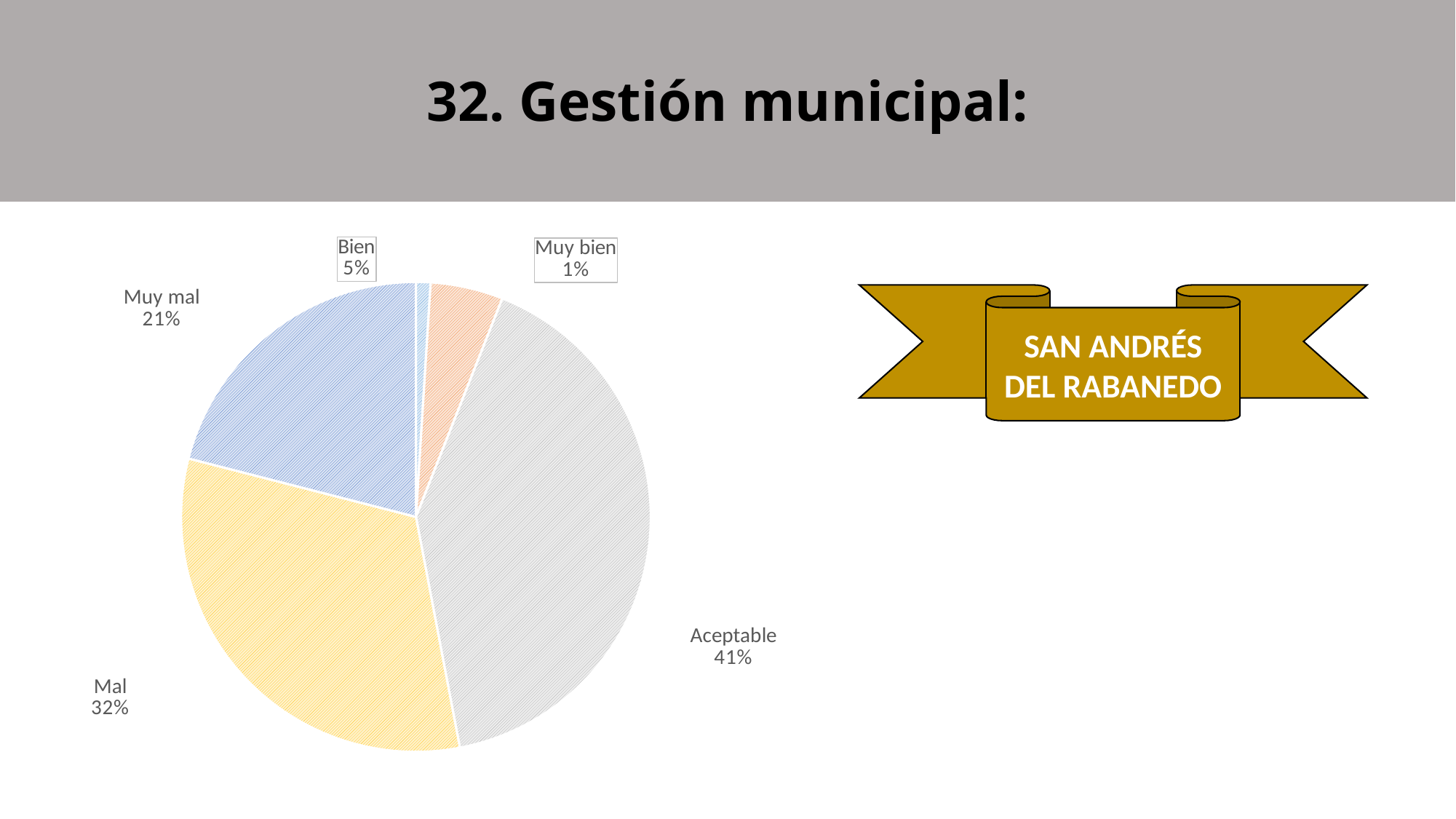
What is the difference between the shares for Aceptable and Mal? 9% What share of the pie does Mal represent? 32% What type of chart is shown on the slide? pie chart What is the value shown for Bien? 5% Which category has the largest share of the pie? Aceptable Which is larger, the share for Mal or the share for Muy mal? Mal What share of the pie does Muy mal represent? 21% What share of the pie does Aceptable represent? 41% What is the title of the slide containing the chart? 32. Gestión municipal: What is the value shown for Muy bien? 1% Which category has the smallest share of the pie? Muy bien How many categories are shown in the pie chart? 5